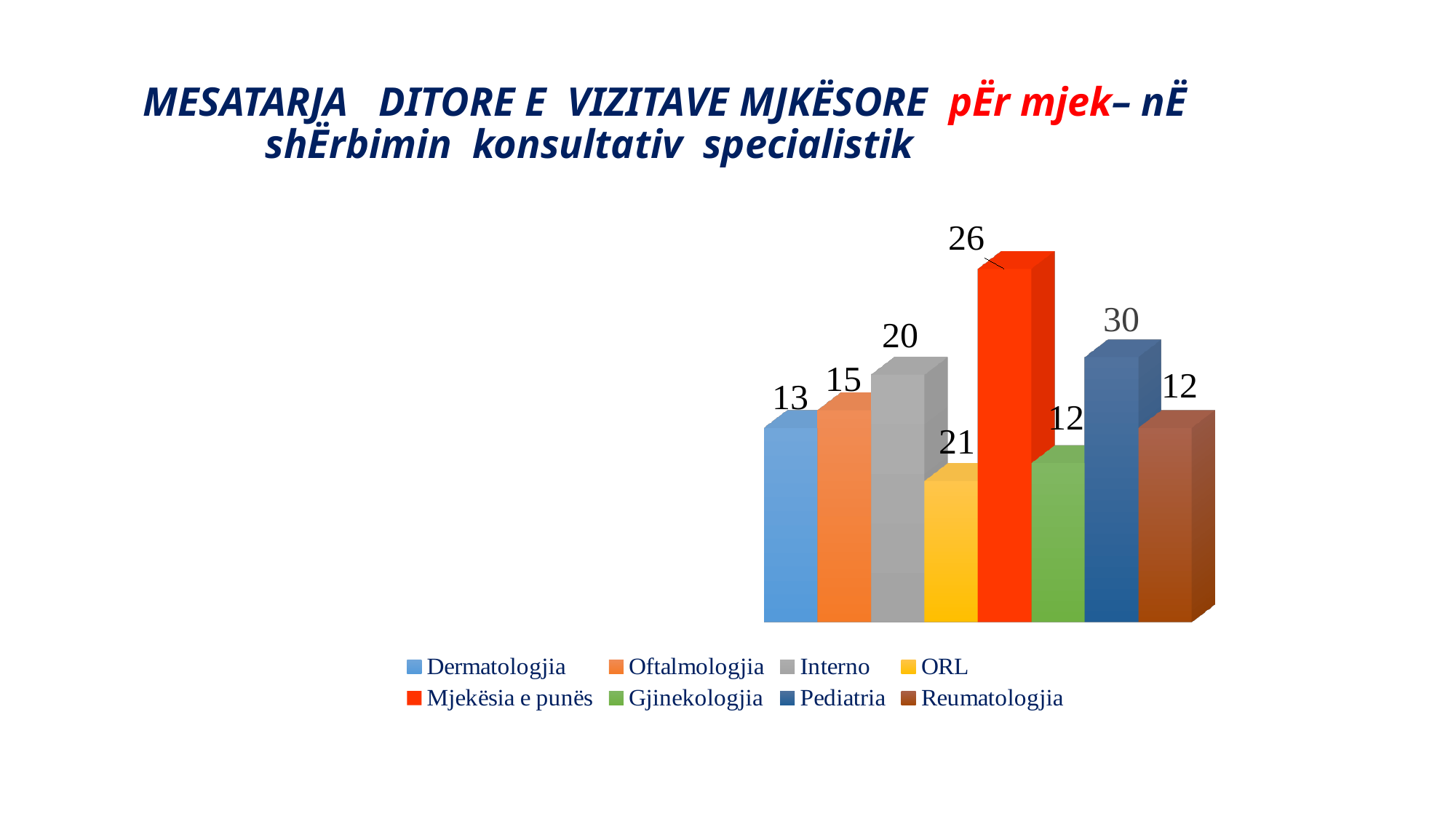
What is the value shown for Oftalmologjia? 15 What is the value shown for Reumatologjia? 12 Which has a larger value, Interno or Dermatologjia? Interno What is the value shown for Mjekësia e punës? 26 Which legend entry is shown in red? Mjekësia e punës What is the difference between the values for Interno and Dermatologjia? 7 How many bars are plotted in the chart? 8 How many entries does the legend list? 8 What is the value shown for Interno? 20 What kind of chart is shown on the slide? Bar chart What is the value shown for Dermatologjia? 13 What is the value shown for Pediatria? 30